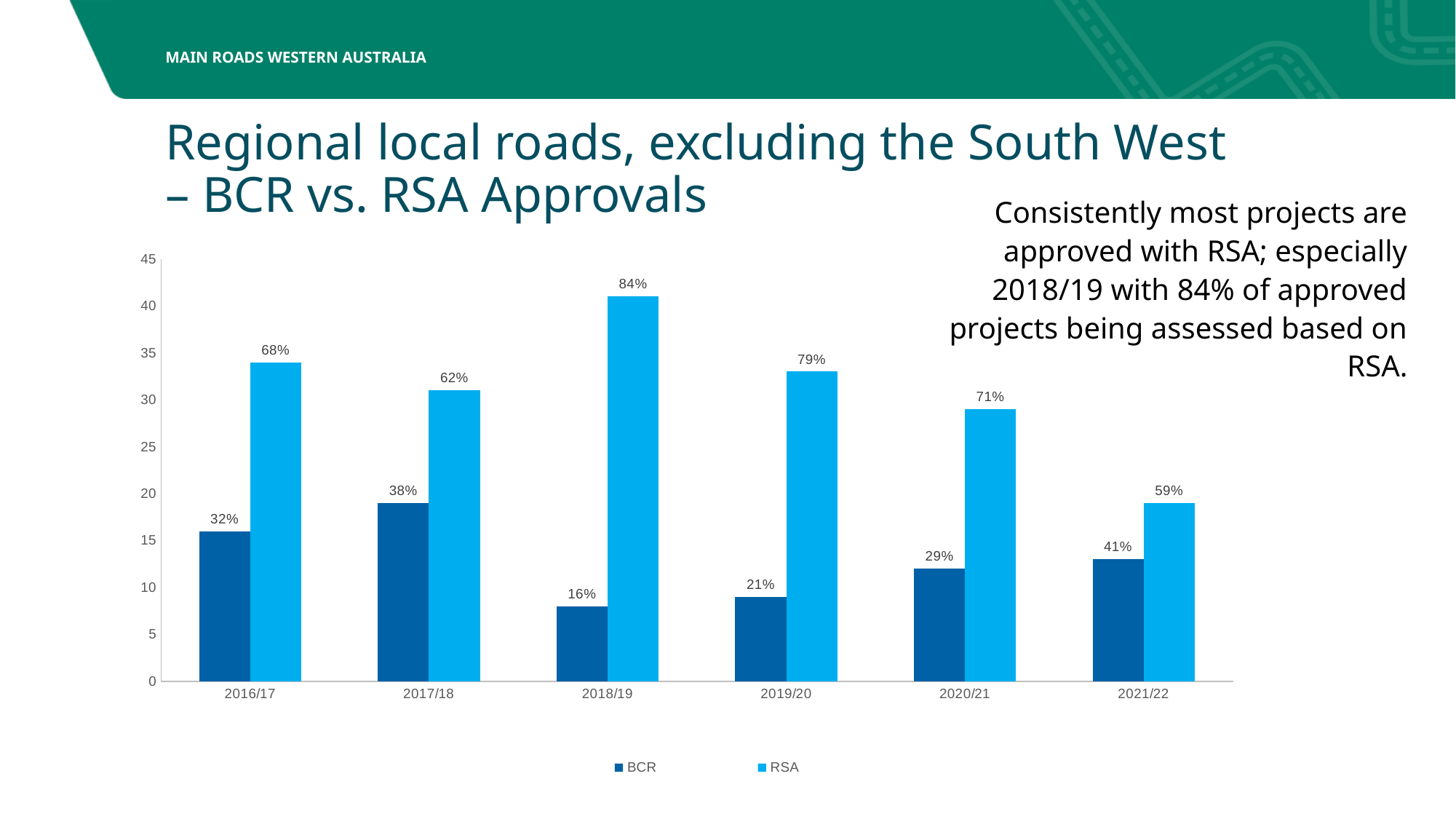
How many years are shown on the x axis? 6 What kind of chart is shown on the slide? bar chart What percentage label is shown on the RSA bar for 2020/21? 71% In which year is the BCR bar the shortest? 2018/19 What percentage label is shown on the BCR bar for 2021/22? 41% What is the difference between the RSA and BCR percentage labels in 2018/19? 68 percentage points What percentage label is shown on the RSA bar for 2018/19? 84% How many series does the legend list? 2 In 2017/18, which bar is taller, BCR or RSA? RSA Is the BCR bar for 2019/20 greater or less than 10 on the y axis? less In which year is the RSA bar the tallest? 2018/19 Is the RSA bar for 2018/19 greater or less than 40 on the y axis? greater